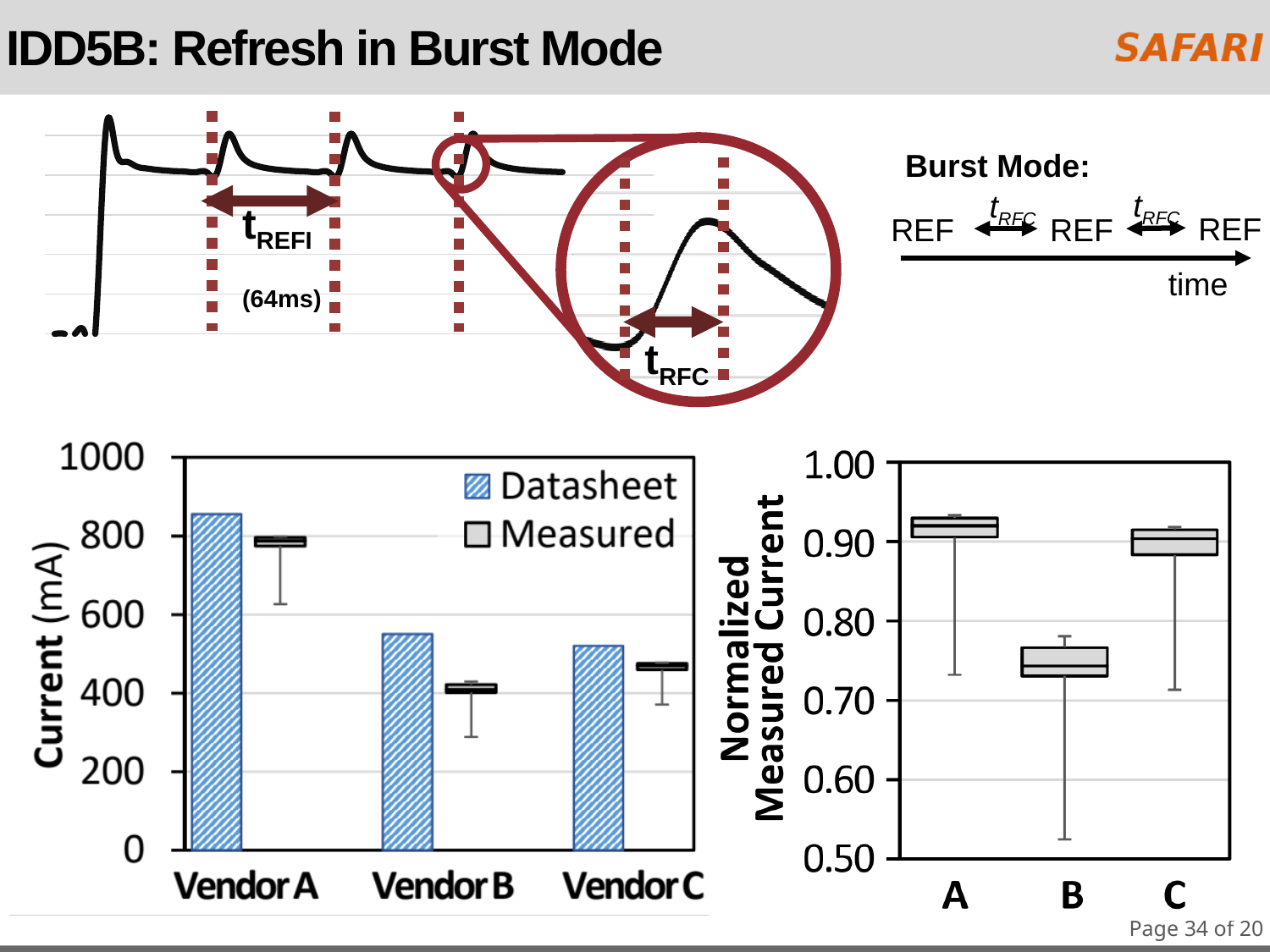
In the left chart (Current (mA)), for Vendor A, which is larger: the Datasheet value or the Measured value? Datasheet In the left chart (Current (mA)), which vendor has the highest Datasheet current? Vendor A How many vendors are shown on the x axis of the left chart (Current (mA))? 3 How many series does the legend of the left chart (Current (mA)) list? 2 In the left chart (Current (mA)), which vendor has the lowest Measured current? Vendor B In the right chart (Normalized Measured Current), which vendor has the lowest normalized measured current? B In the left chart (Current (mA)), is the Datasheet value for Vendor C greater or less than 400? greater In the right chart (Normalized Measured Current), is the value for B greater or less than 0.80? less In the left chart (Current (mA)), is the Datasheet value for Vendor A greater or less than 800? greater What is the y-axis label of the left chart? Current (mA)